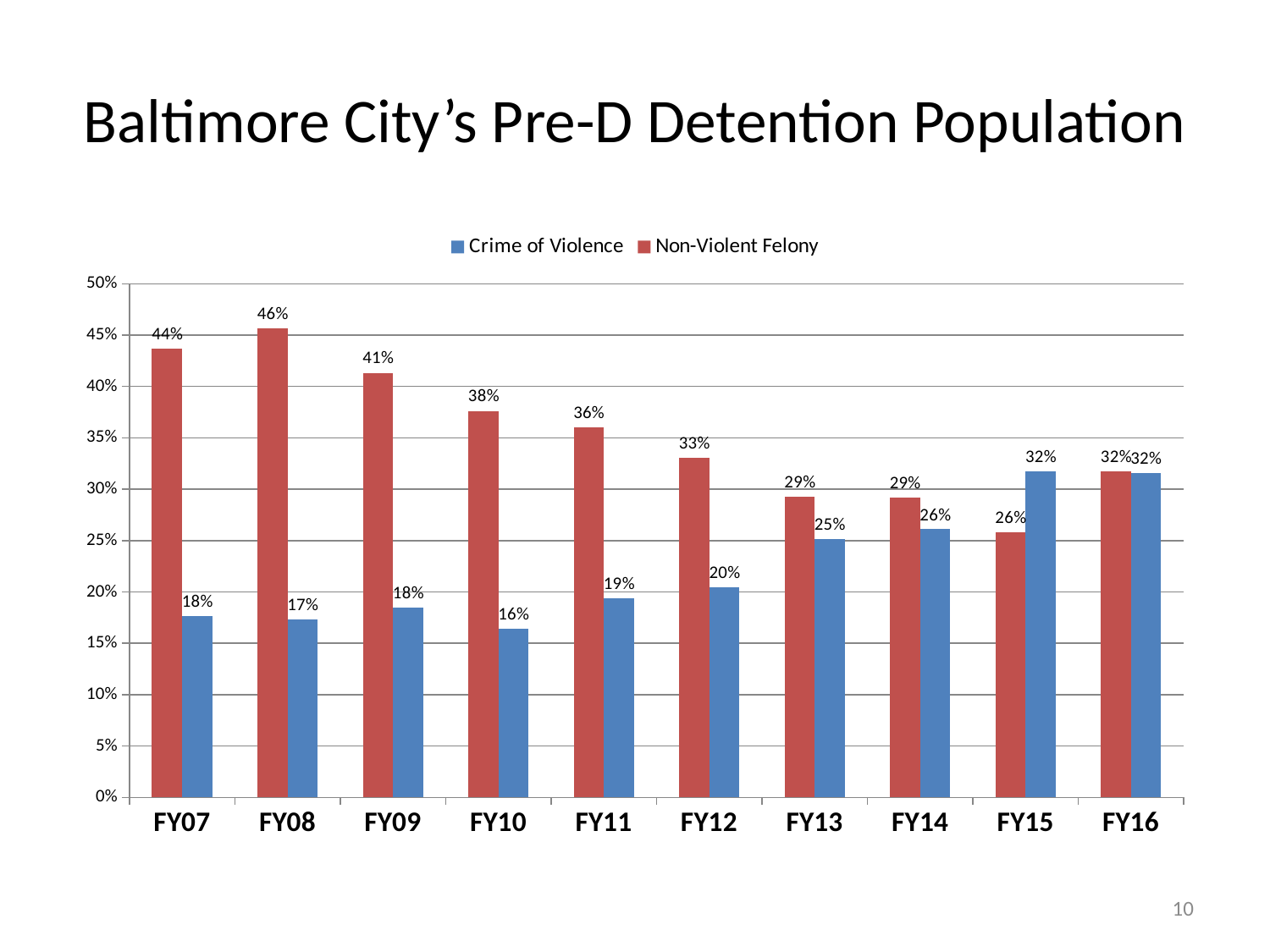
In FY15, which series has the larger value, Crime of Violence or Non-Violent Felony? Crime of Violence How many series does the legend list? 2 Which colour represents the Crime of Violence series? Blue What is the Crime of Violence value for FY13? 25% How many fiscal years are shown on the x axis? 10 What is the Non-Violent Felony value for FY08? 46% In which fiscal year is the Crime of Violence share lowest? FY10 What is the difference between the Non-Violent Felony and Crime of Violence values in FY07? 26% What is the Crime of Violence value for FY10? 16% In which fiscal year is the Non-Violent Felony share highest? FY08 Does the Non-Violent Felony series generally rise or fall from FY08 to FY15? Fall What kind of chart is shown on the slide? Bar chart